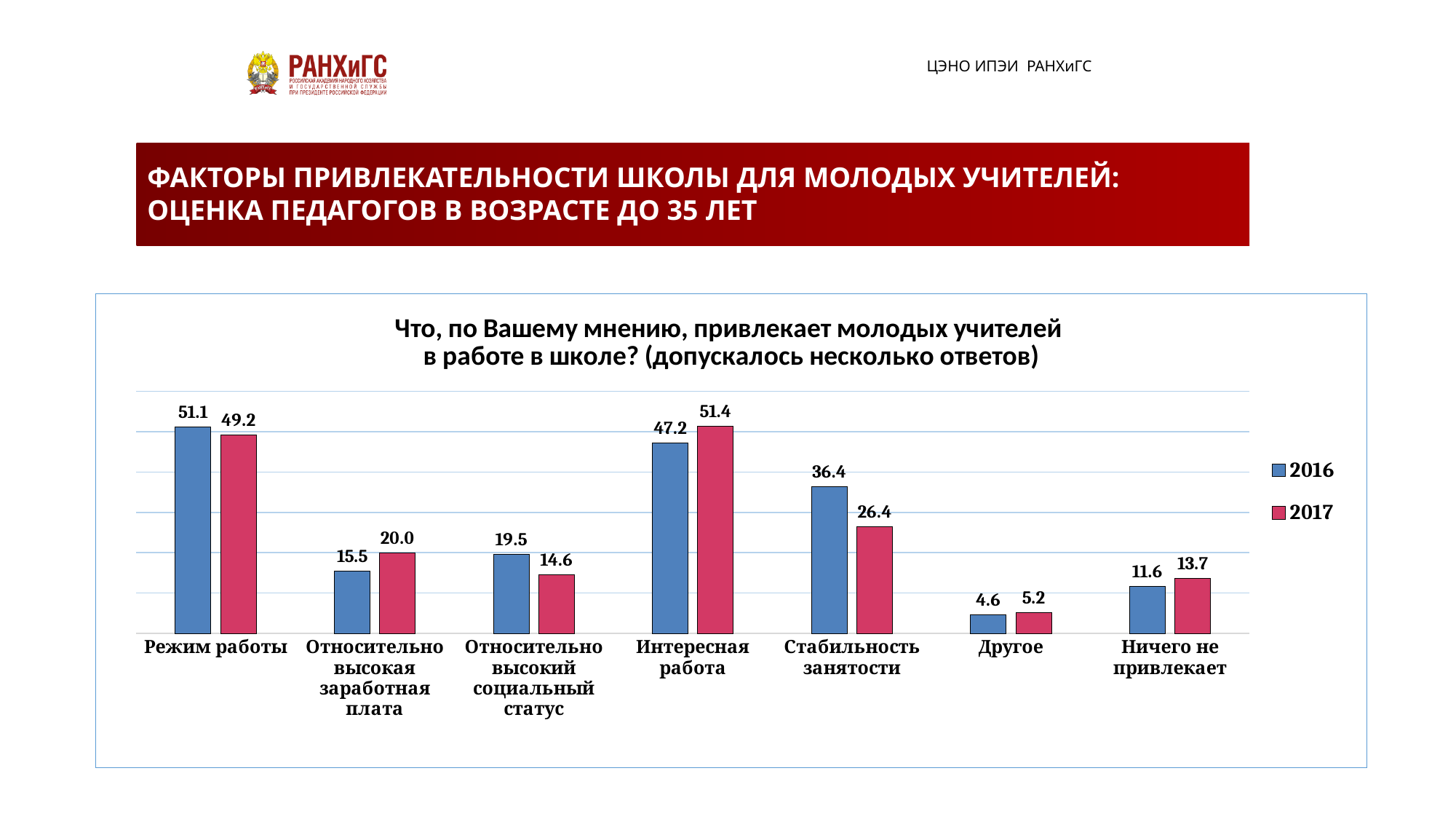
What is the 2016 value for "Режим работы"? 51.1 Which is larger for "Относительно высокий социальный статус": the 2016 value or the 2017 value? 2016 What kind of chart is shown on the slide? Bar chart Which category has the lowest 2016 value? Другое What is the 2017 value for "Относительно высокая заработная плата"? 20.0 What is the difference between the 2017 values for "Интересная работа" and "Режим работы"? 2.2 How many categories are shown on the x axis? 7 What is the 2017 value for "Стабильность занятости"? 26.4 How many series does the legend list? 2 What is the difference between the 2016 and 2017 values for "Стабильность занятости"? 10.0 Which category has the highest 2017 value? Интересная работа Which colour represents the 2017 series in the legend? Red